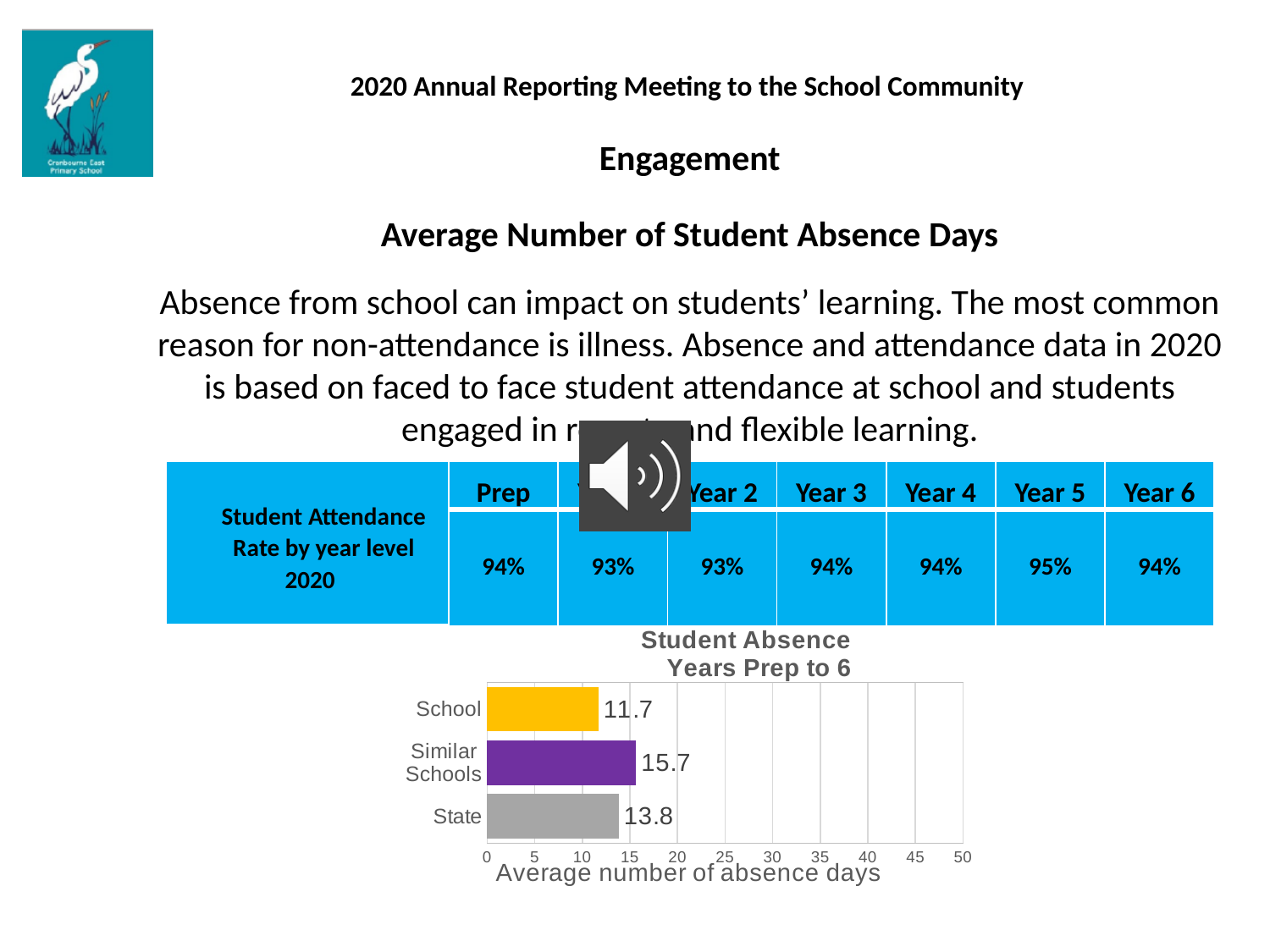
Is the value for Similar Schools greater or less than 20? less What is the average number of absence days for Similar Schools? 15.7 What is the average number of absence days for State? 13.8 What is the average number of absence days for School? 11.7 Which category has the highest average number of absence days? Similar Schools Which category has the lowest average number of absence days? School What is the difference in average absence days between State and School? 2.1 What kind of chart is shown on the slide? Bar chart Which has more average absence days, State or School? State How many categories are shown in the chart? 3 What is the title of the chart? Student Absence Years Prep to 6 What is the difference in average absence days between Similar Schools and School? 4.0